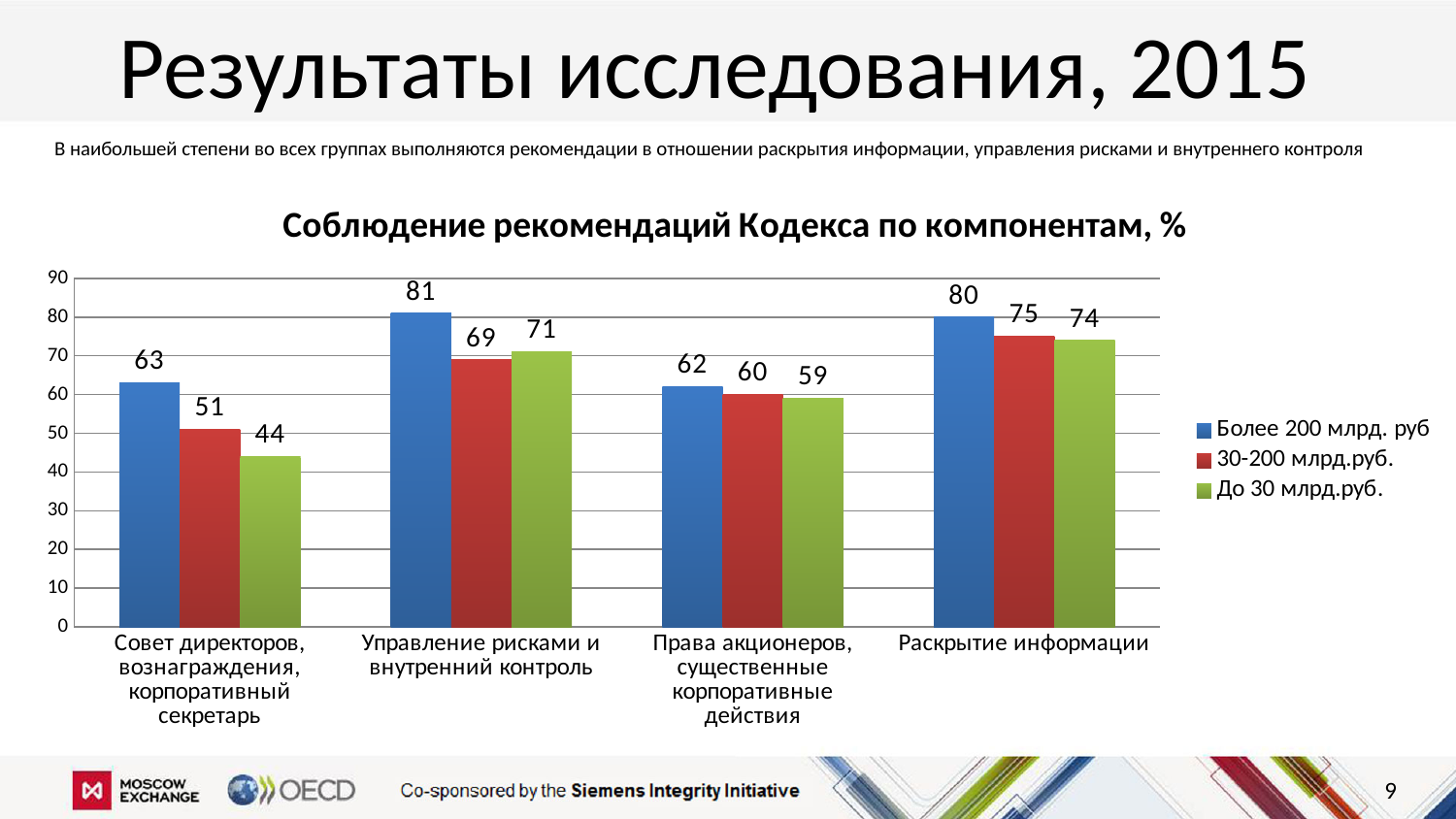
Which category has the highest value for the 'Более 200 млрд. руб' series? Управление рисками и внутренний контроль What is the difference between the 'Более 200 млрд. руб' and 'До 30 млрд.руб.' values in the 'Совет директоров, вознаграждения, корпоративный секретарь' category? 19 How many series does the legend list? 3 What kind of chart is shown on the slide? bar chart Is the value for 'До 30 млрд.руб.' in the 'Права акционеров, существенные корпоративные действия' category greater or less than 70? less What is the value for '30-200 млрд.руб.' in the 'Раскрытие информации' category? 75 What is the value for 'До 30 млрд.руб.' in the 'Совет директоров, вознаграждения, корпоративный секретарь' category? 44 What is the value for 'Более 200 млрд. руб' in the 'Управление рисками и внутренний контроль' category? 81 In the 'Управление рисками и внутренний контроль' category, which is larger: the '30-200 млрд.руб.' value or the 'До 30 млрд.руб.' value? До 30 млрд.руб. Which category has the lowest value for the '30-200 млрд.руб.' series? Совет директоров, вознаграждения, корпоративный секретарь What is the title of the chart? Соблюдение рекомендаций Кодекса по компонентам, % How many categories are shown on the x axis? 4